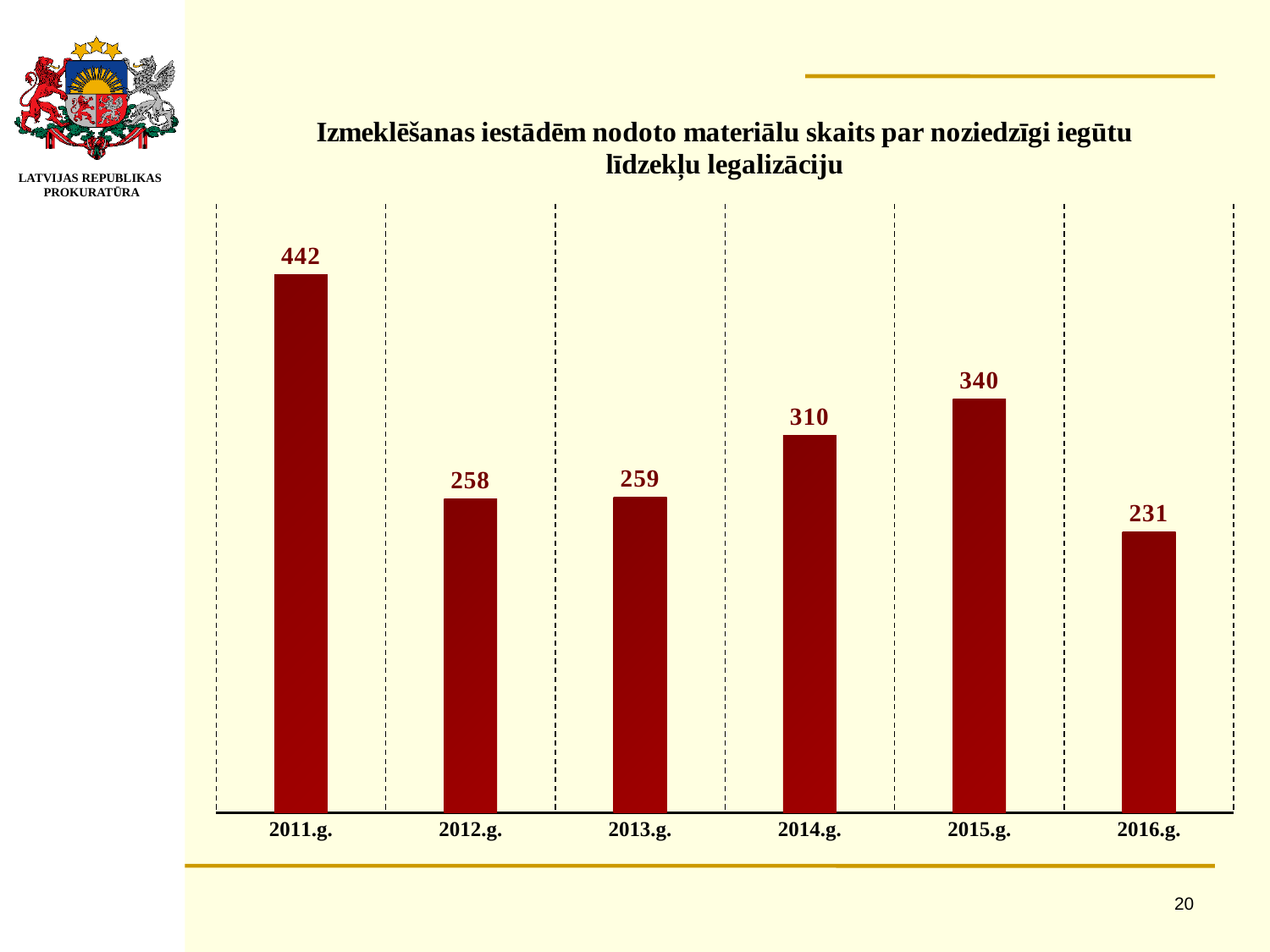
What kind of chart is this? bar chart What is the difference between the values for 2015.g. and 2016.g.? 109 How many years are shown on the x axis? 6 Do the values rise or fall from 2012.g. to 2015.g.? rise Which year has the lowest value? 2016.g. What is the value for 2014.g.? 310 What colour are the bars? dark red What is the value for 2016.g.? 231 What is the difference between the values for 2011.g. and 2012.g.? 184 Which is larger, the value for 2014.g. or the value for 2015.g.? 2015.g. Which year has the highest value? 2011.g. What is the value for 2011.g.? 442